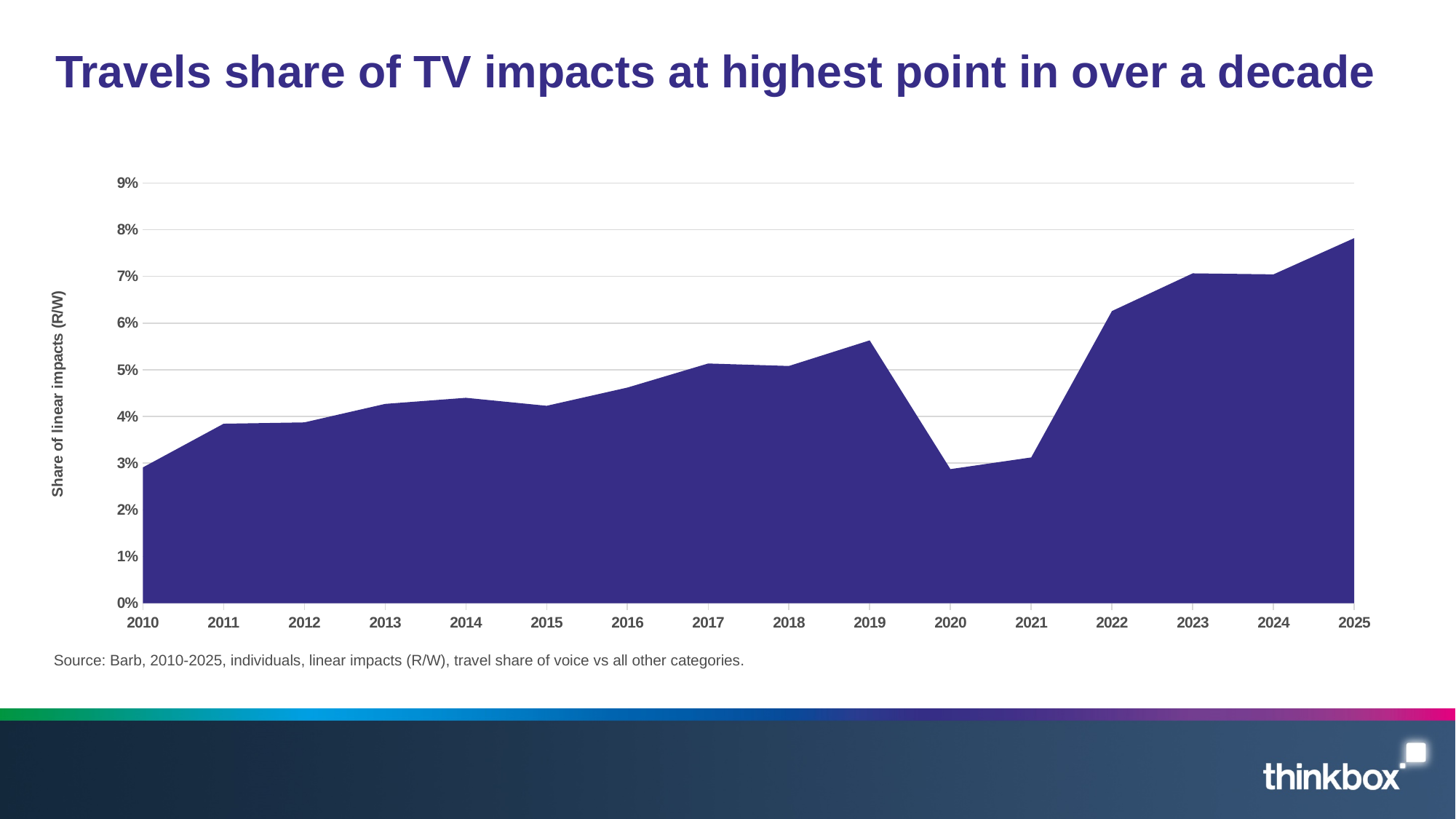
What is the label on the vertical axis of the chart? Share of linear impacts (R/W) How many years are plotted along the x axis of the chart? 16 Which year has the larger share of linear impacts, 2019 or 2020? 2019 What kind of chart is shown on the slide? Area chart Does the share of linear impacts rise or fall between 2022 and 2025? rise What is the title of the chart on the slide? Travels share of TV impacts at highest point in over a decade Which year has the highest share of linear impacts? 2025 Which year has the larger share of linear impacts, 2021 or 2022? 2022 Is the value for 2016 greater or less than 5%? less Is the value for 2025 greater or less than 7%? greater Is the value for 2022 greater or less than 6%? greater